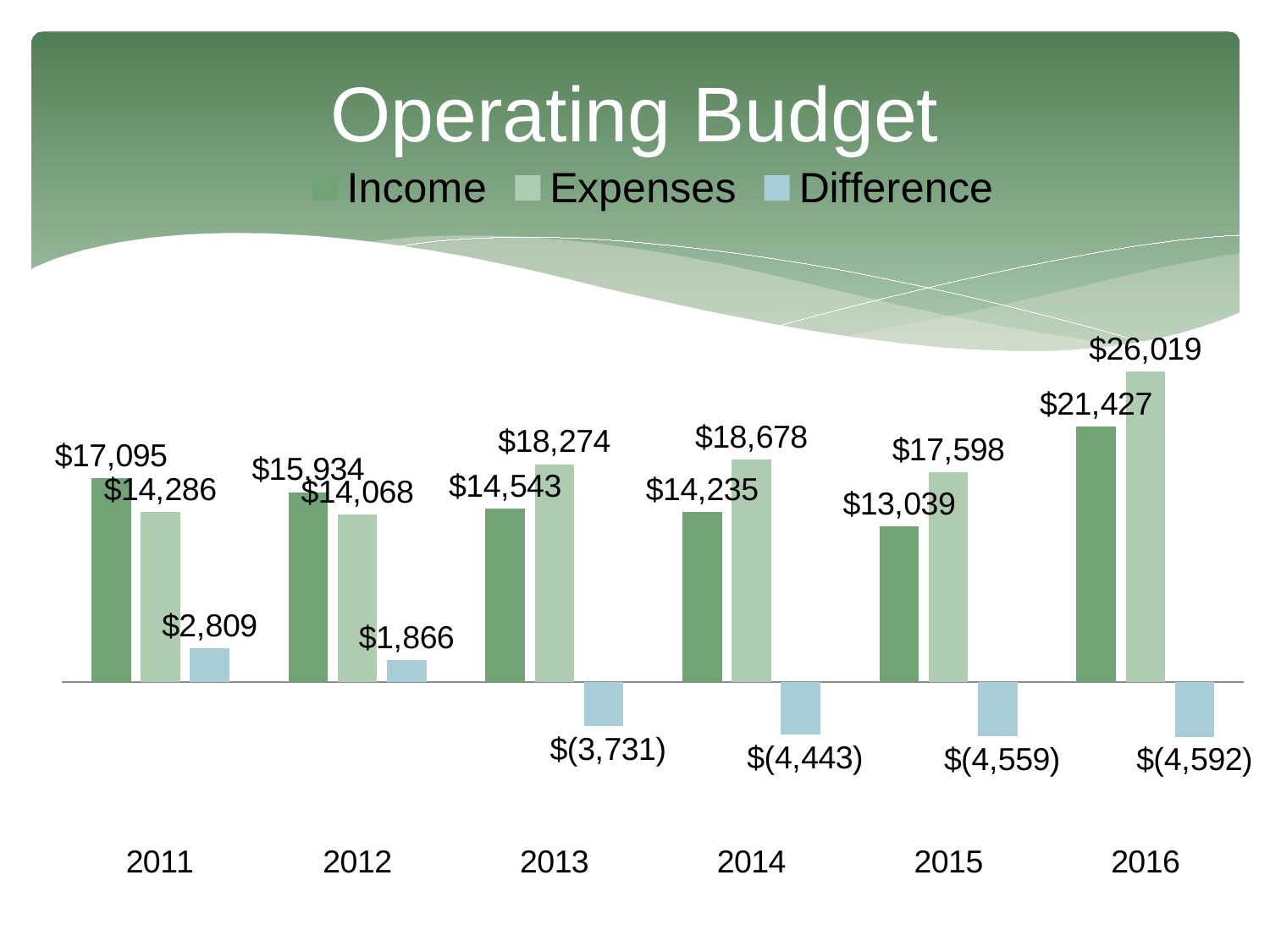
How many series does the legend list? 3 Which year has the lowest Income value? 2015 What is the Difference value for 2013? $(3,731) What kind of chart is shown on the slide? Bar chart What is the difference between Expenses and Income in 2011? $2,809 What is the title of the chart? Operating Budget Which year has the highest Expenses value? 2016 How many years are shown on the x axis? 6 What is the Income value for 2016? $21,427 Which is larger in 2012, Income or Expenses? Income Does the Difference value rise or fall from 2011 to 2015? Fall What is the Expenses value for 2014? $18,678